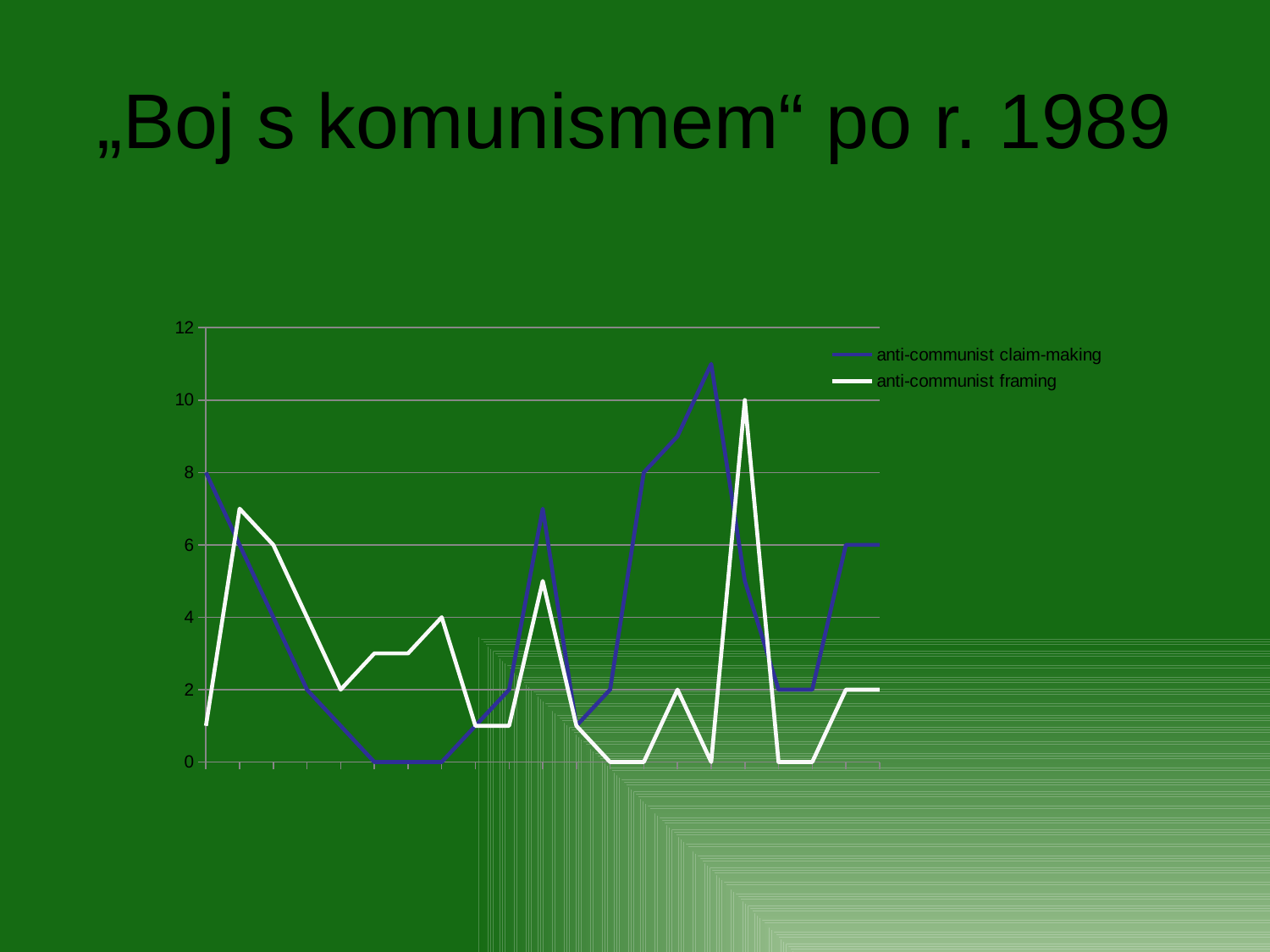
What is the lowest value reached by the anti-communist framing series? 0 Is the highest value reached by the anti-communist framing series greater or less than 8? greater What is the value of the anti-communist claim-making series at the last point on the right of the chart? 6 What is the highest value reached by the anti-communist framing series? 10 Which series reaches the higher peak, anti-communist claim-making or anti-communist framing? anti-communist claim-making Which series is drawn with the white line? anti-communist framing What is the lowest value reached by the anti-communist claim-making series? 0 How many series does the chart legend list? 2 What is the value of the anti-communist claim-making series at the first point on the left of the chart? 8 What kind of chart is shown on the slide? line chart Is the highest value reached by the anti-communist claim-making series greater or less than 10? greater What is the highest value shown on the vertical axis of the chart? 12